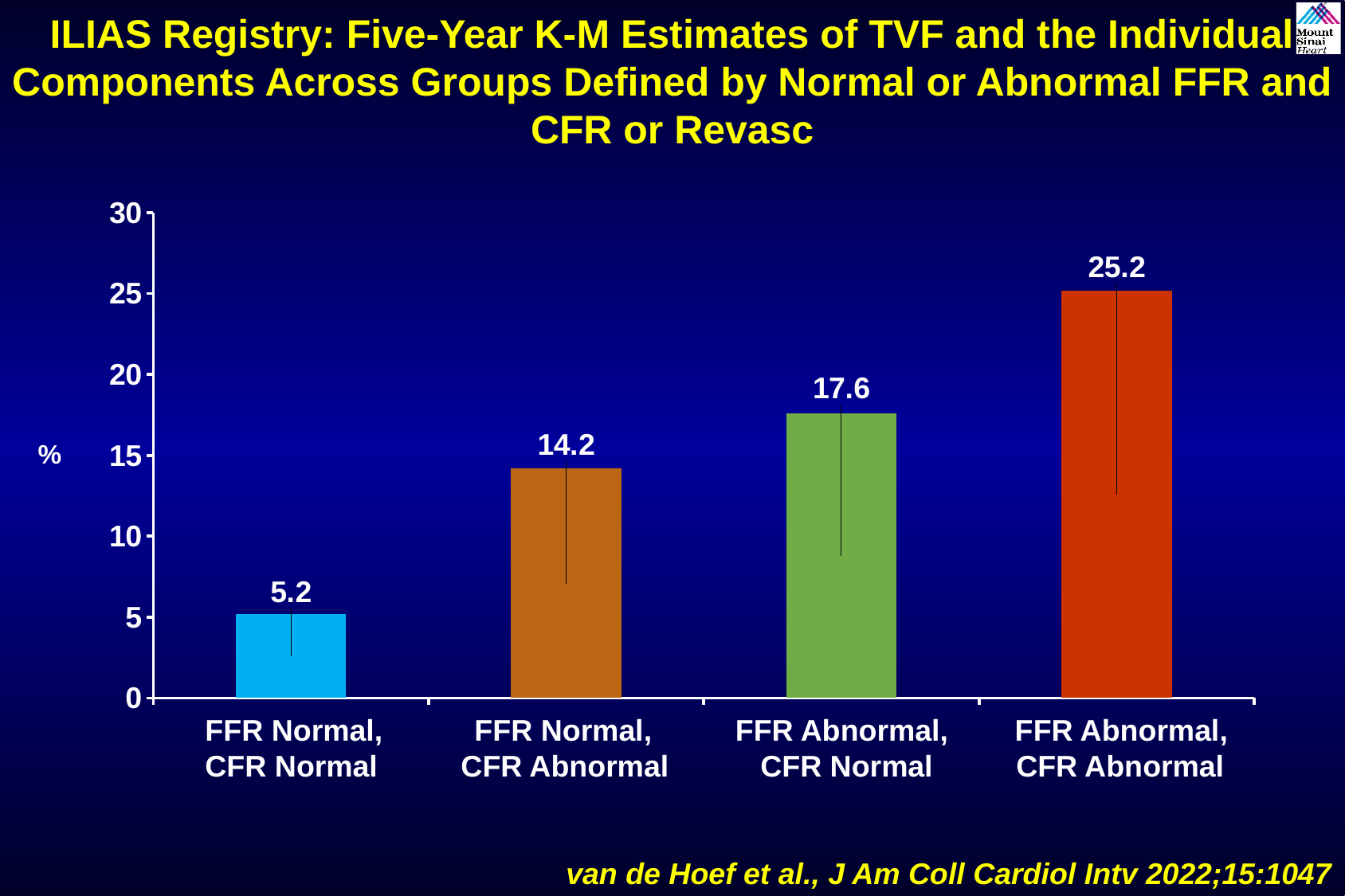
Which group has the highest value? FFR Abnormal, CFR Abnormal What kind of chart is shown on the slide? bar chart Is the value for FFR Abnormal, CFR Normal greater or less than 20? less What is the value for the FFR Abnormal, CFR Normal group? 17.6 Which group has the lowest value? FFR Normal, CFR Normal What is the difference between the values for FFR Abnormal, CFR Abnormal and FFR Normal, CFR Normal? 20.0 What is the value for the FFR Normal, CFR Normal group? 5.2 How many groups are shown on the x axis? 4 Which is larger, the value for FFR Normal, CFR Abnormal or the value for FFR Abnormal, CFR Normal? FFR Abnormal, CFR Normal What is the value for the FFR Normal, CFR Abnormal group? 14.2 What is the value for the FFR Abnormal, CFR Abnormal group? 25.2 Do the values rise or fall from left to right along the x axis? rise